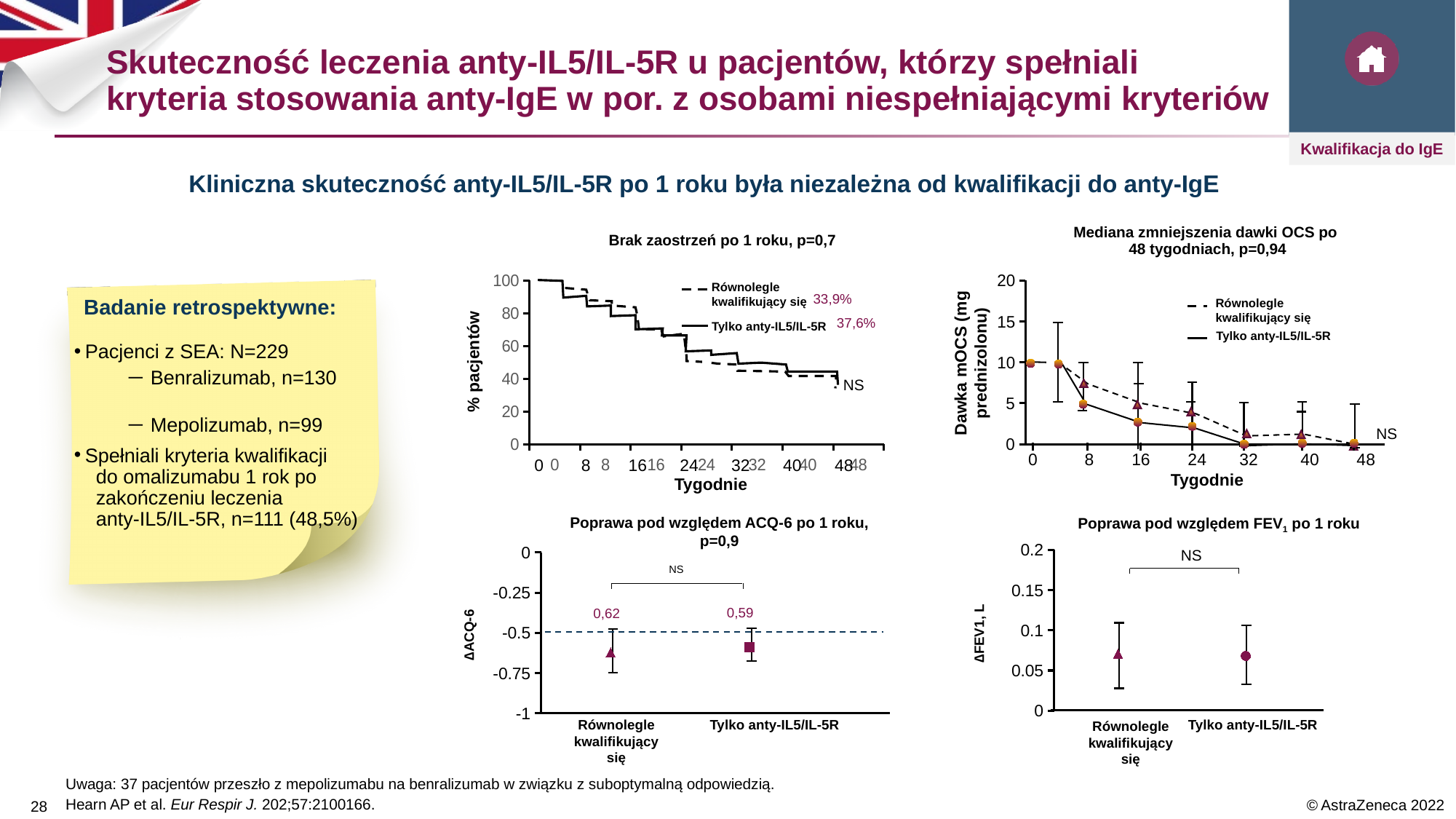
How many categories are shown on the x axis of the chart titled "Poprawa pod względem ACQ-6 po 1 roku, p=0,9"? 2 In the chart titled "Mediana zmniejszenia dawki OCS po 48 tygodniach, p=0,94", do the values rise or fall from week 0 to week 48? Fall In the chart titled "Brak zaostrzeń po 1 roku, p=0,7", which series has the higher labelled percentage? Tylko anty-IL5/IL-5R In the chart titled "Poprawa pod względem ACQ-6 po 1 roku, p=0,9", what value is labelled for "Tylko anty-IL5/IL-5R"? 0,59 How many series does the legend list in the chart titled "Mediana zmniejszenia dawki OCS po 48 tygodniach, p=0,94"? 2 What kind of chart is the one titled "Mediana zmniejszenia dawki OCS po 48 tygodniach, p=0,94"? Line chart In the chart titled "Brak zaostrzeń po 1 roku, p=0,7", what is the difference between the two labelled percentages (37,6% and 33,9%)? 3,7% In the chart titled "Brak zaostrzeń po 1 roku, p=0,7", what percentage is labelled for the "Równolegle kwalifikujący się" series? 33,9% In the chart titled "Brak zaostrzeń po 1 roku, p=0,7", what percentage is labelled for the "Tylko anty-IL5/IL-5R" series? 37,6% In the chart titled "Poprawa pod względem FEV1 po 1 roku", is the plotted value for "Równolegle kwalifikujący się" greater or less than 0.1? less In the chart titled "Mediana zmniejszenia dawki OCS po 48 tygodniach, p=0,94", what is the mOCS dose at week 0? 10 In the chart titled "Poprawa pod względem ACQ-6 po 1 roku, p=0,9", what value is labelled for "Równolegle kwalifikujący się"? 0,62